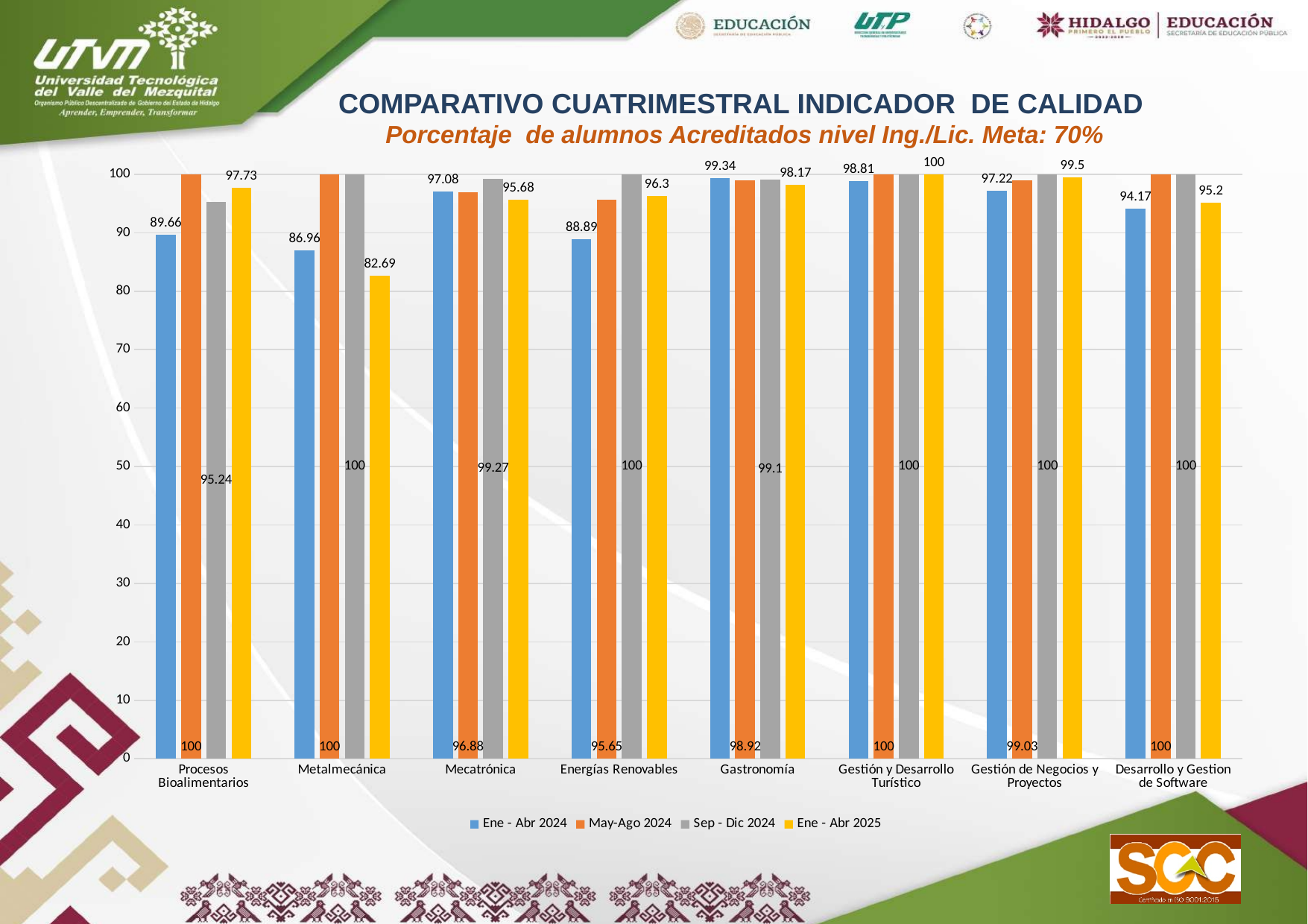
Which category has the highest Ene - Abr 2024 value? Gastronomía How many categories are shown on the x axis? 8 What is the difference between the Ene - Abr 2025 and Ene - Abr 2024 values for Procesos Bioalimentarios? 8.07 Is the Ene - Abr 2024 value for Metalmecánica greater or less than 90? less What is the May-Ago 2024 value for Energías Renovables? 95.65 What kind of chart is shown on the slide? bar chart What is the Ene - Abr 2025 value for Metalmecánica? 82.69 Which is larger for Gastronomía, the Ene - Abr 2024 value or the Ene - Abr 2025 value? Ene - Abr 2024 What is the Sep - Dic 2024 value for Mecatrónica? 99.27 How many series does the legend list? 4 Which category has the lowest Ene - Abr 2025 value? Metalmecánica What is the Ene - Abr 2024 value for Procesos Bioalimentarios? 89.66